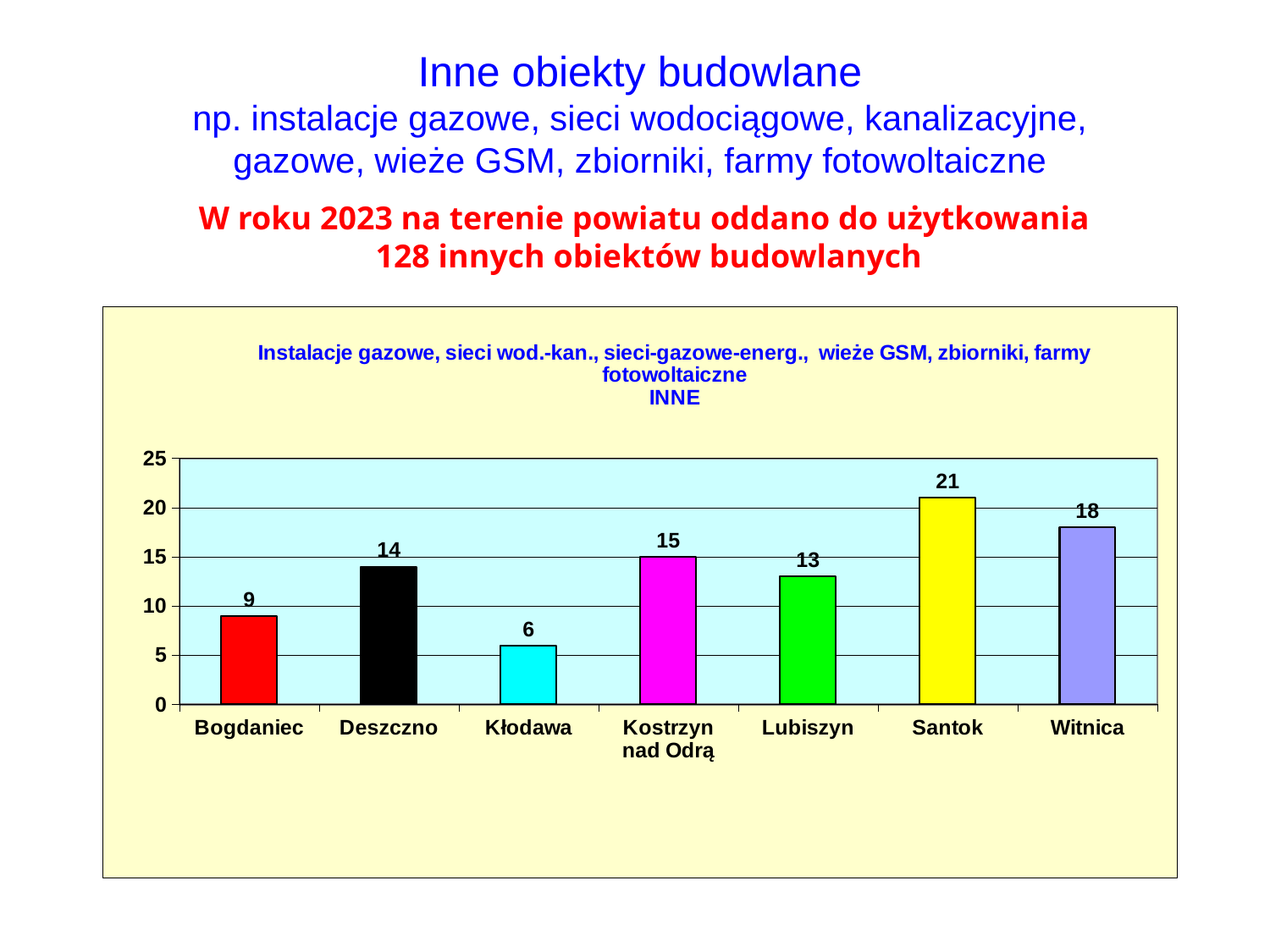
What is the difference between the values for Santok and Bogdaniec? 12 Which category has the highest value? Santok What is the value for Kłodawa? 6 What colour is the bar for Santok? yellow What is the value for Kostrzyn nad Odrą? 15 Is the value for Witnica greater or less than 15? greater Which category has the lowest value? Kłodawa What kind of chart is shown on the slide? bar chart What is the difference between the values for Witnica and Kłodawa? 12 How many categories are shown on the x axis? 7 What is the value for Santok? 21 Which is larger, the value for Deszczno or the value for Lubiszyn? Deszczno